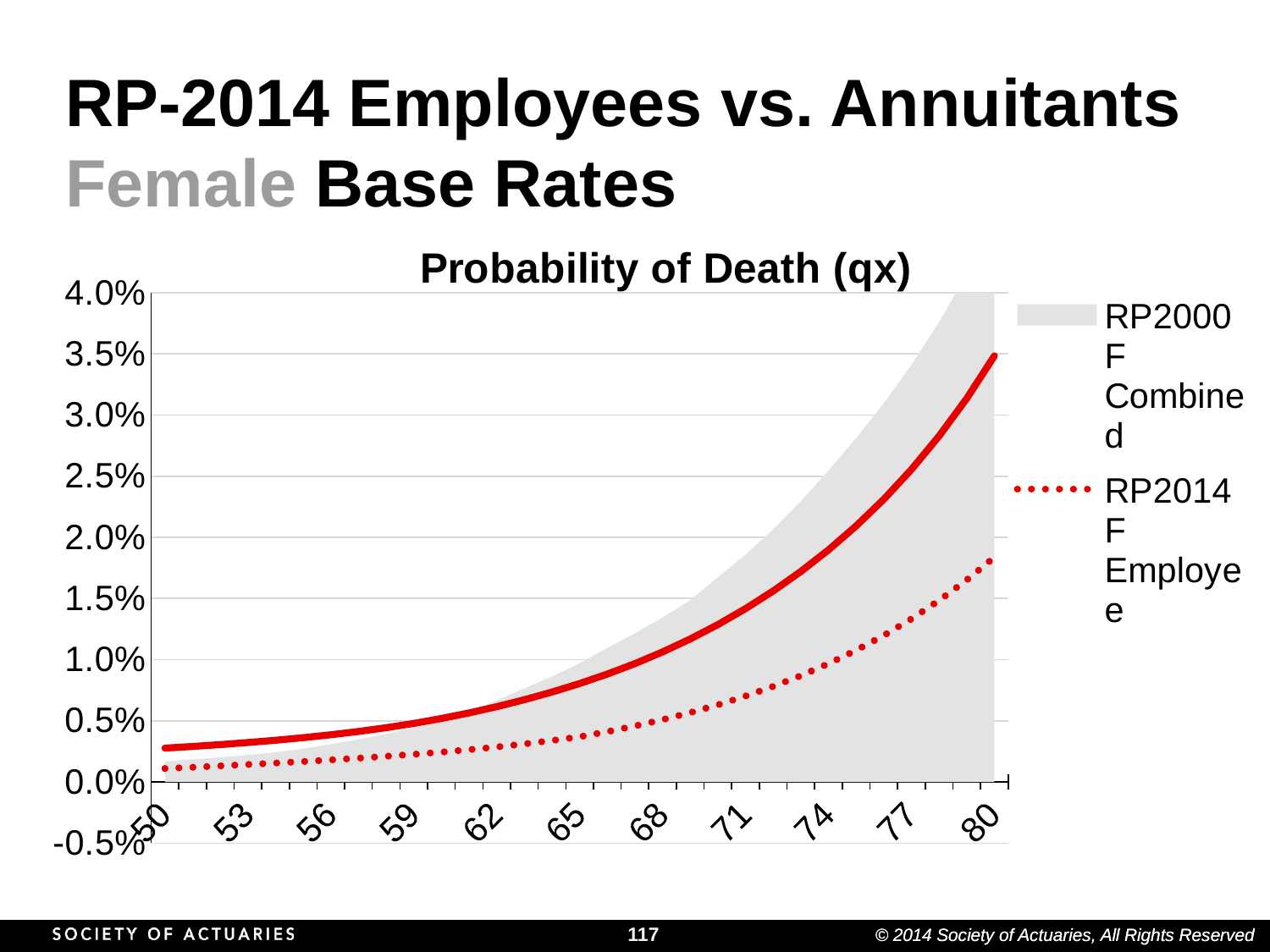
Do the RP2014 F Employee values rise or fall as age increases along the x axis? rise At age 80, which is larger: RP2000 F Combined or RP2014 F Employee? RP2000 F Combined At which age is the RP2014 F Employee value highest? 80 Which series is shown as a grey shaded area in the legend? RP2000 F Combined How many series does the chart legend list? 2 Is the RP2014 F Employee value at age 80 greater or less than 1.5%? greater How many age labels are shown on the x axis? 11 What is the title of the chart? Probability of Death (qx) Is the RP2000 F Combined value at age 80 greater or less than 3.5%? greater Is the RP2014 F Employee value at age 80 greater or less than 2.0%? less At which age is the RP2014 F Employee value lowest? 50